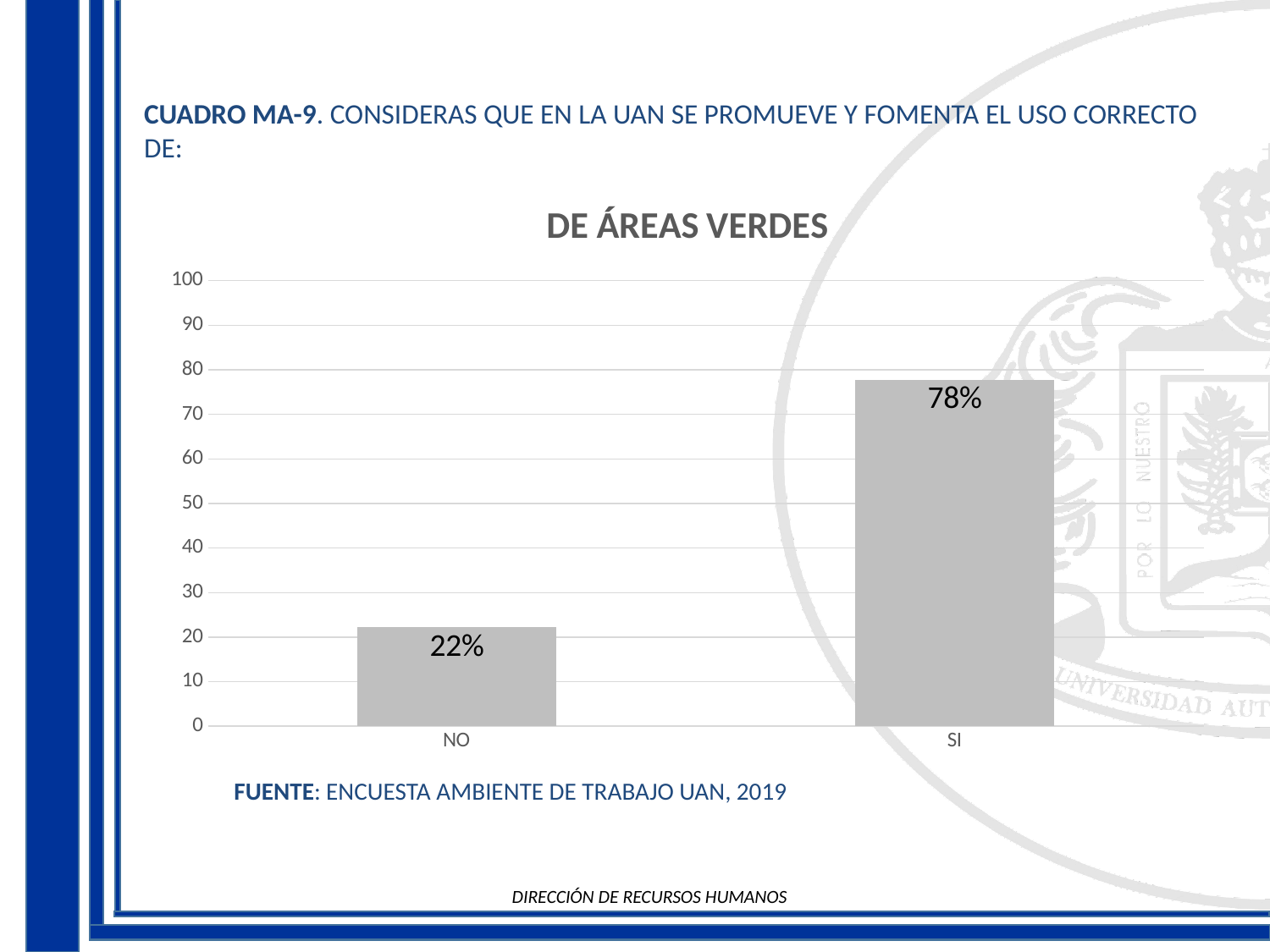
What is the title of the chart? DE ÁREAS VERDES Which is larger, the value for NO or the value for SI? SI What is the difference between the values for SI and NO? 56% Is the value for SI greater or less than 70? greater What kind of chart is shown on the slide? bar chart How many categories are shown on the x axis? 2 Is the value for NO greater or less than 30? less What is the value for NO? 22% What is the highest value shown on the y axis? 100 What is the value for SI? 78% Which category has the highest value? SI Which category has the lowest value? NO